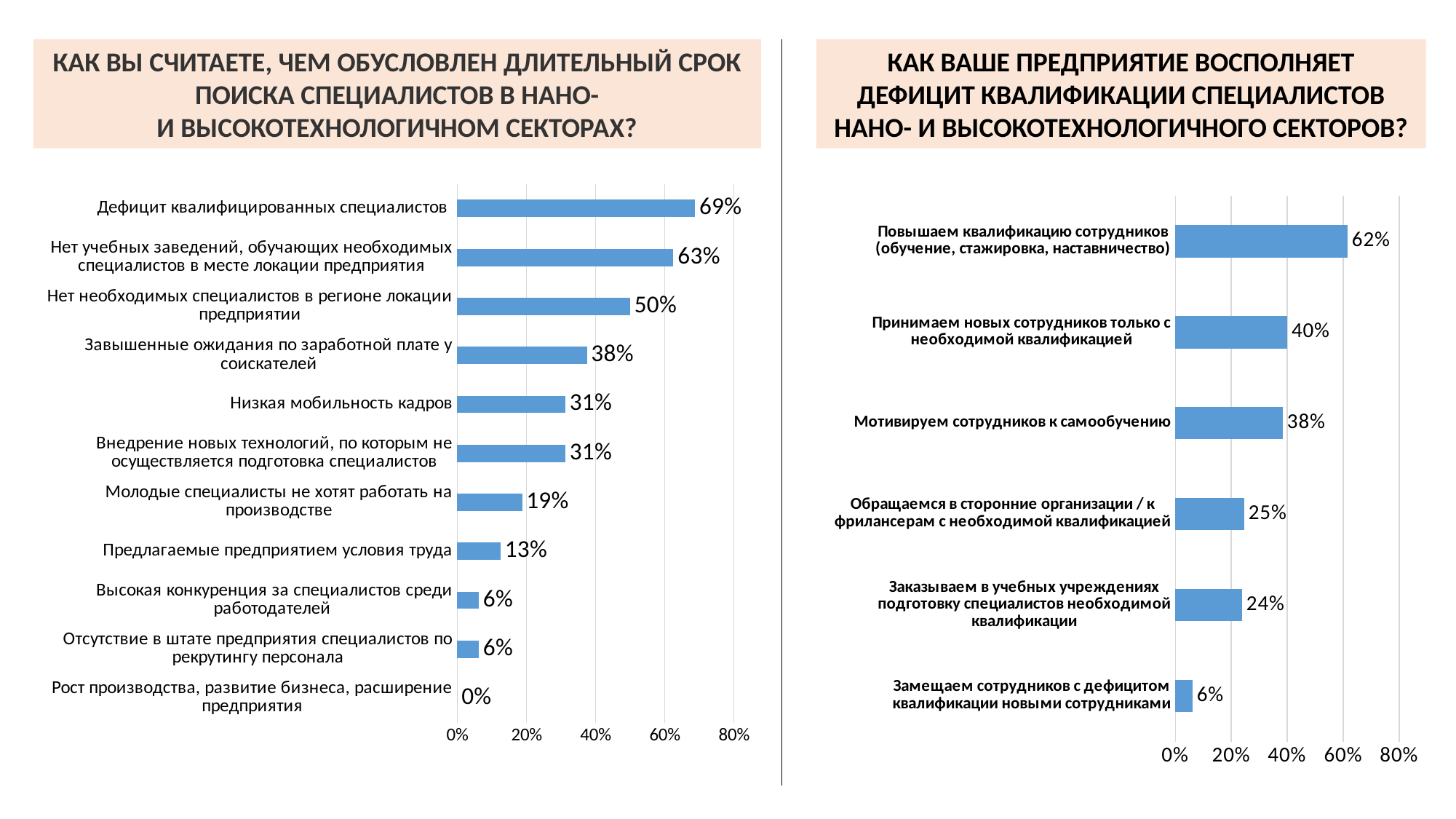
In the right chart, how many categories are shown? 6 In the left chart, what is the value for «Низкая мобильность кадров»? 31% In the left chart, what is the value for «Дефицит квалифицированных специалистов»? 69% In the left chart, how many categories are shown? 11 In the left chart, which category has the highest value? Дефицит квалифицированных специалистов In the left chart, which category has the lowest value? Рост производства, развитие бизнеса, расширение предприятия In the right chart, which category has the lowest value? Замещаем сотрудников с дефицитом квалификации новыми сотрудниками In the right chart, which is larger: «Принимаем новых сотрудников только с необходимой квалификацией» or «Обращаемся в сторонние организации / к фрилансерам с необходимой квалификацией»? Принимаем новых сотрудников только с необходимой квалификацией In the left chart, what is the difference between «Нет необходимых специалистов в регионе локации предприятии» and «Завышенные ожидания по заработной плате у соискателей»? 12% What type of chart is the right chart? Bar chart In the right chart, which category has the highest value? Повышаем квалификацию сотрудников (обучение, стажировка, наставничество) In the right chart, what is the value for «Мотивируем сотрудников к самообучению»? 38%